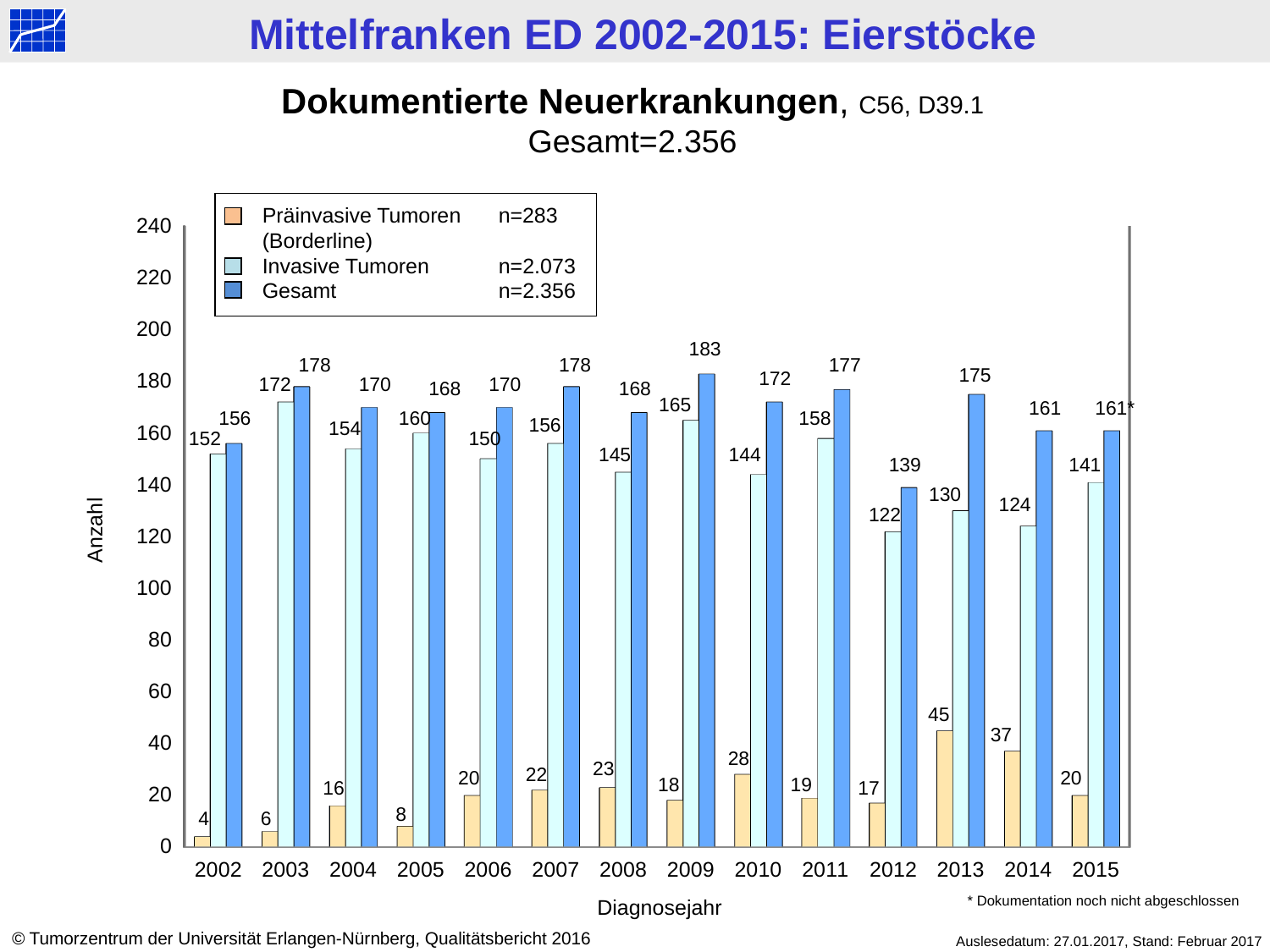
What kind of chart is shown on the slide? bar chart How many series does the legend list? 3 What is the value for Präinvasive Tumoren (Borderline) in 2013? 45 What is the difference between the Gesamt values for 2009 and 2012? 44 What is the Gesamt value for 2009? 183 According to the legend, what is the total n for Invasive Tumoren? n=2.073 Which is larger: the Invasive Tumoren value in 2003 or in 2011? 2003 Which year has the lowest Gesamt value? 2012 Which year has the highest Gesamt value? 2009 Which year has the lowest value for Präinvasive Tumoren (Borderline)? 2002 What is the value for Invasive Tumoren in 2012? 122 How many diagnosis years are shown on the x axis? 14